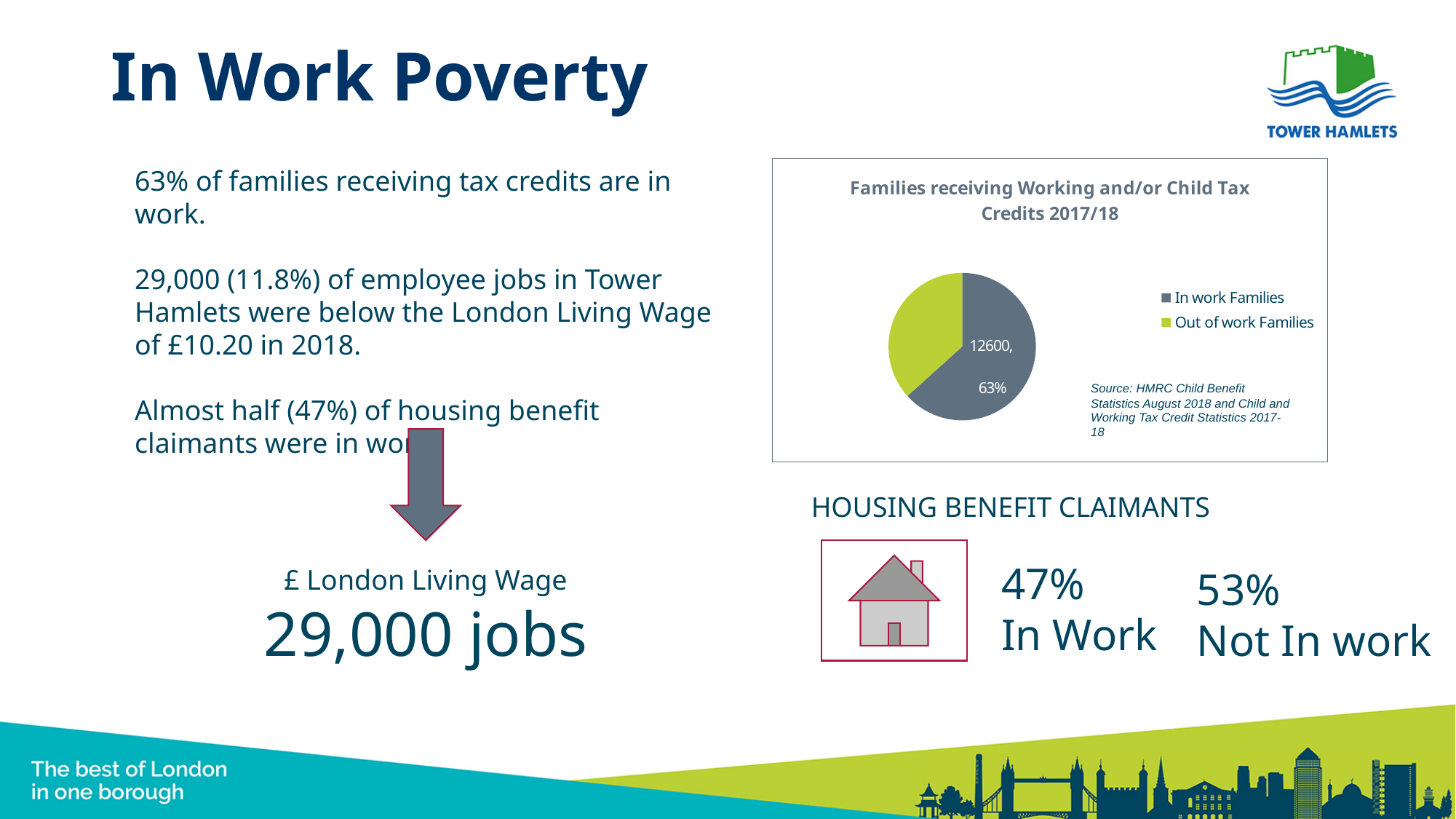
What colour is the Out of work Families slice in the pie chart? green Which slice of the pie chart is the smallest? Out of work Families How many slices does the pie chart have? 2 What is the title of the pie chart? Families receiving Working and/or Child Tax Credits 2017/18 What number is printed on the In work Families slice of the pie chart? 12600 How many entries does the legend of the pie chart list? 2 Which slice of the pie chart is the largest? In work Families What share of the pie does the In work Families slice represent? 63% What kind of chart is shown on the slide? pie chart Which is larger in the pie chart, In work Families or Out of work Families? In work Families Is the share of the Out of work Families slice greater or less than 50%? less